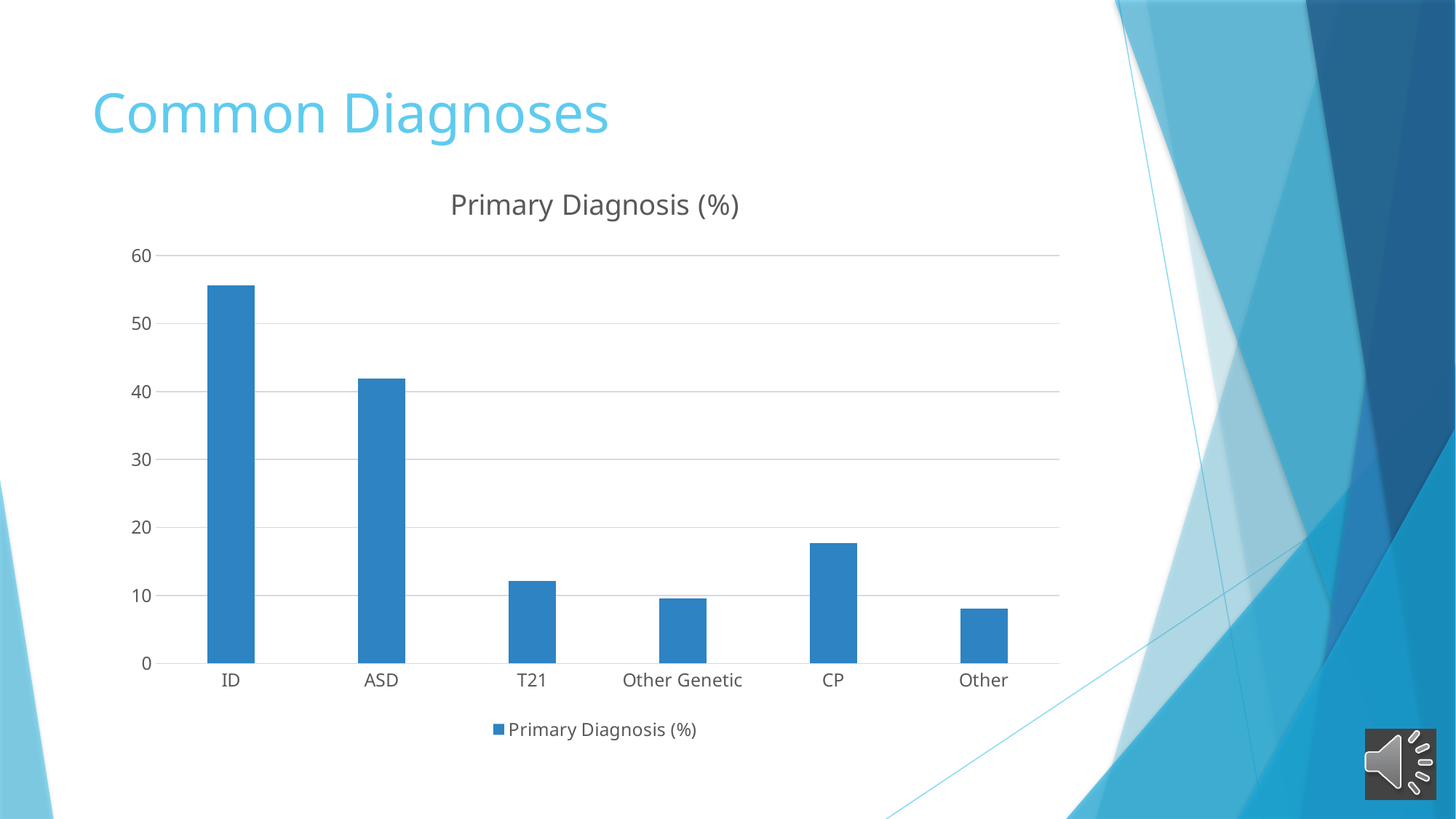
How many series does the legend list? 1 Which category has the highest value? ID Which is larger, the value for ASD or the value for ID? ID What is the title of the chart? Primary Diagnosis (%) Is the value for CP greater or less than 20? less How many categories are shown on the x axis of the chart? 6 What type of chart is shown on the slide? bar chart Which category has the lowest value? Other Is the value for T21 greater or less than 10? greater Which is larger, the value for CP or the value for T21? CP Is the value for ID greater or less than 50? greater